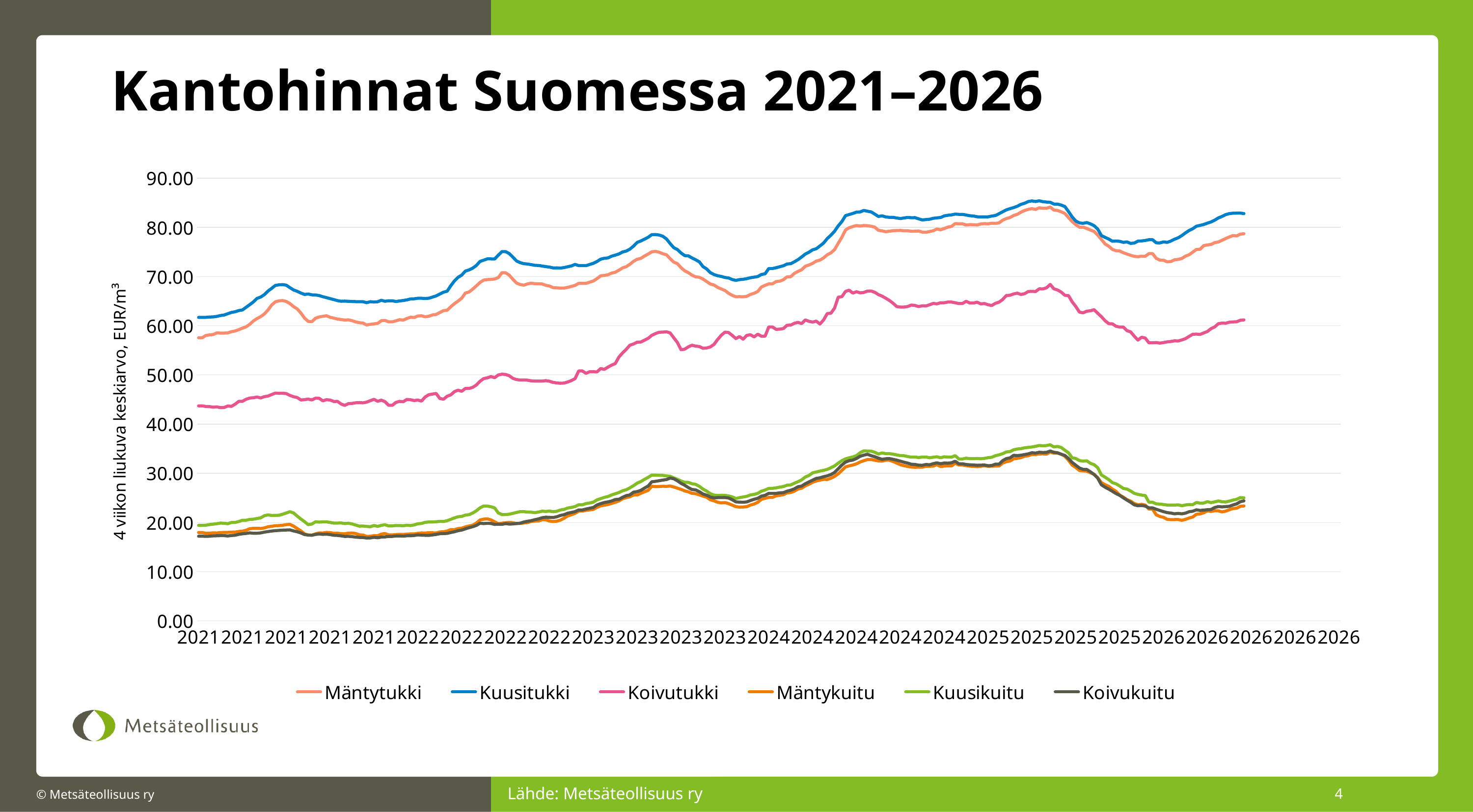
Is the highest value of Kuusikuitu greater or less than 40? less Is the value of Koivutukki at the start of 2021 greater or less than 50? less Which is higher throughout the period, Kuusitukki or Mäntytukki? Kuusitukki Which of the three kuitu series (Mäntykuitu, Kuusikuitu, Koivukuitu) runs highest? Kuusikuitu What is the label on the vertical axis? 4 viikon liukuva keskiarvo, EUR/m³ What kind of chart is shown on the slide? line chart Is the peak value of Kuusitukki in 2025 greater or less than 80? greater Which series has the highest values across the whole period? Kuusitukki Does the Koivutukki line rise or fall from 2021 to 2024? rise What is the title of the chart? Kantohinnat Suomessa 2021–2026 How many series does the legend list? 6